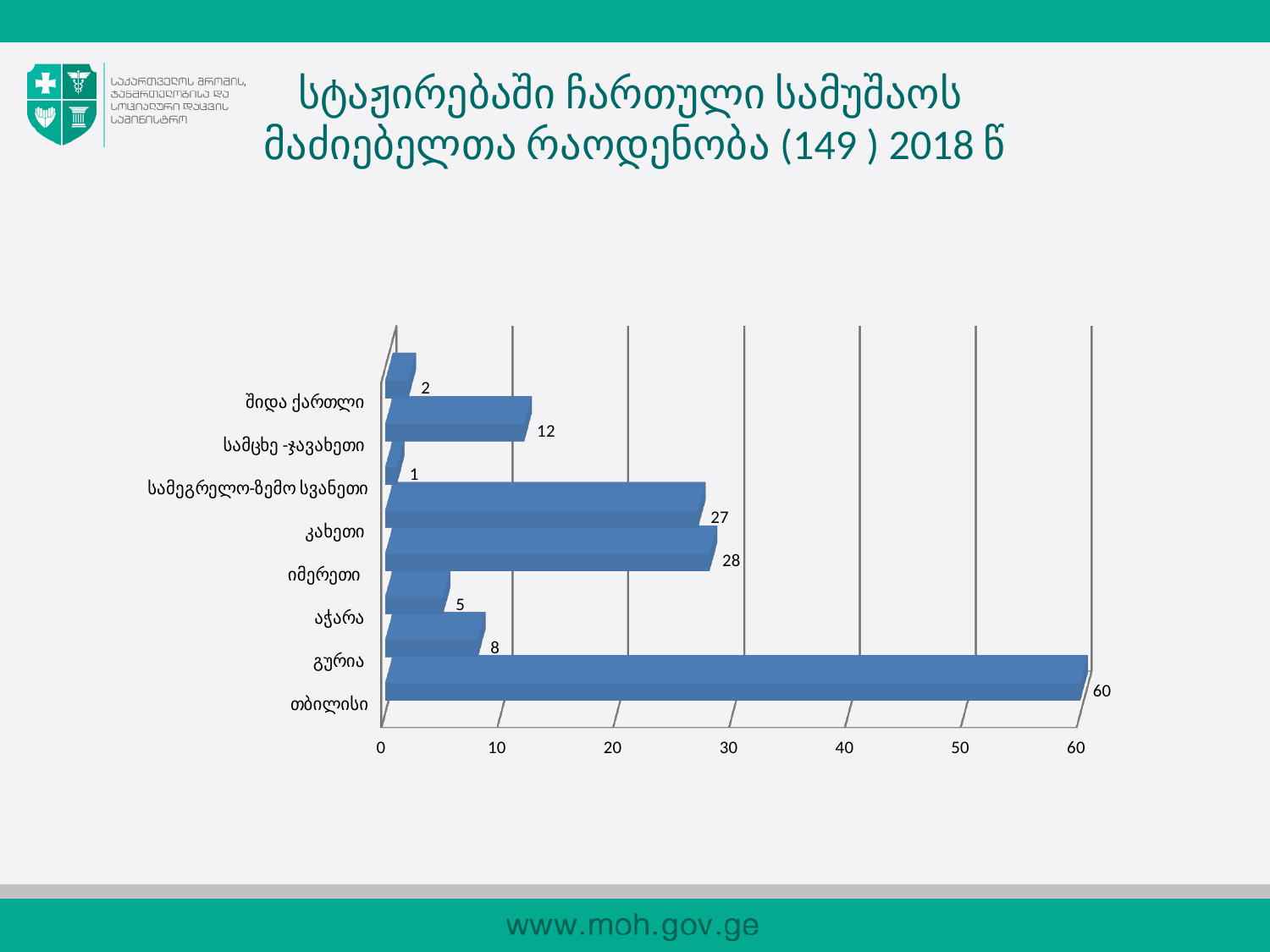
Which is larger, the value for გურია or the value for აჭარა? გურია Which category has the highest value? თბილისი Which category has the lowest value? სამეგრელო-ზემო სვანეთი What is the value for კახეთი? 27 What is the difference between the values for სამცხე -ჯავახეთი and შიდა ქართლი? 10 What is the value for თბილისი? 60 How many categories are plotted in the chart? 8 What type of chart is shown on the slide? bar chart What is the value for სამცხე -ჯავახეთი? 12 What is the highest tick value shown on the horizontal axis? 60 What is the value for იმერეთი? 28 What is the difference between the values for თბილისი and იმერეთი? 32